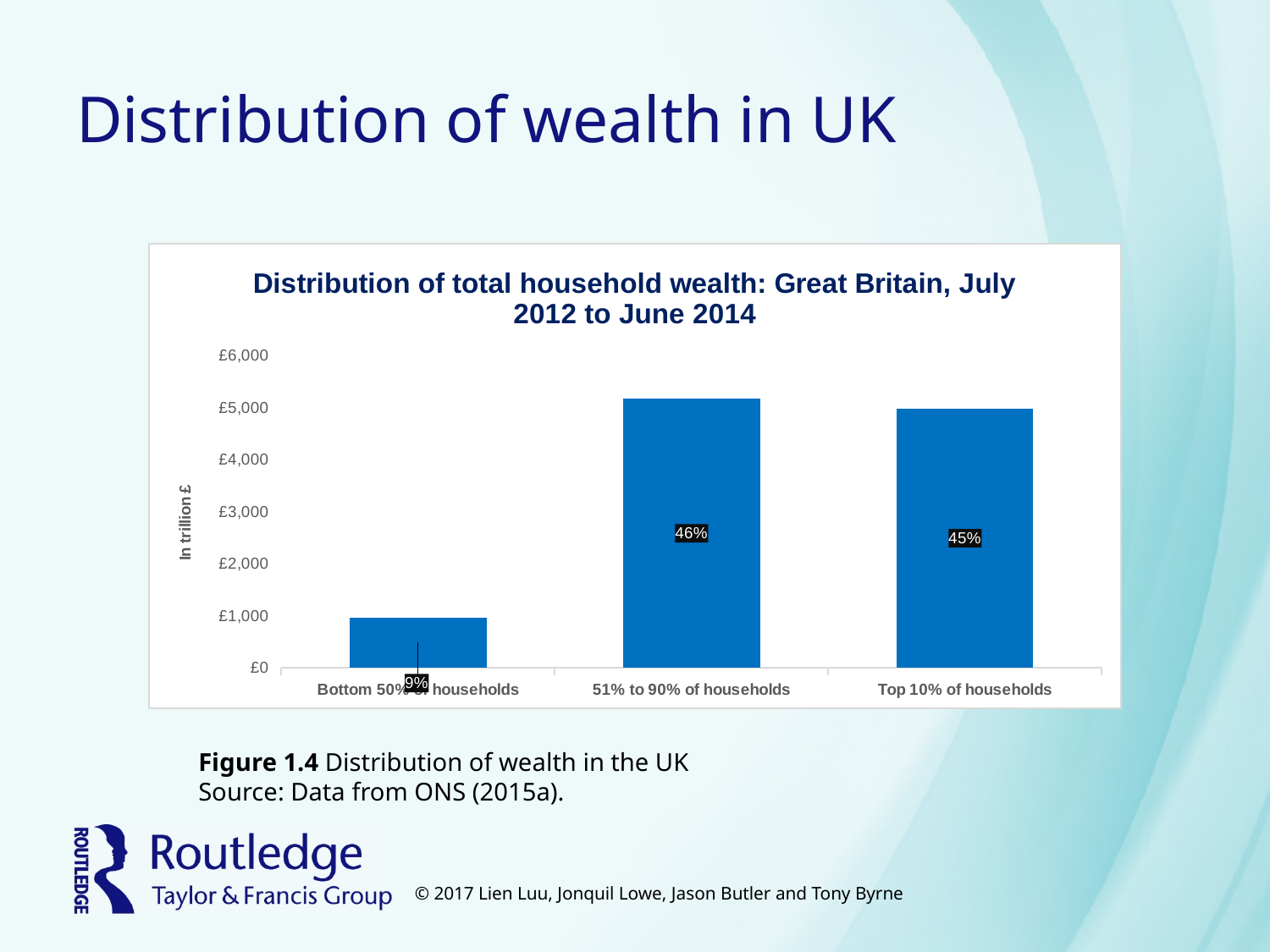
How many categories of households are shown in the chart? 3 Which is larger: the bar for Bottom 50% of households or the bar for Top 10% of households? Top 10% of households Which household group has the highest bar in the chart? 51% to 90% of households What percentage label is shown on the bar for Top 10% of households? 45% Is the value for Top 10% of households greater or less than £4,000? greater What is the label on the vertical axis of the chart? In trillion £ What is the difference in percentage points between the labels for 51% to 90% of households and Bottom 50% of households? 37 percentage points Is the value for Bottom 50% of households greater or less than £2,000? less What percentage label is shown on the bar for 51% to 90% of households? 46% What percentage label is shown on the bar for Bottom 50% of households? 9% Which household group has the lowest bar in the chart? Bottom 50% of households What type of chart is shown on the slide? Bar chart